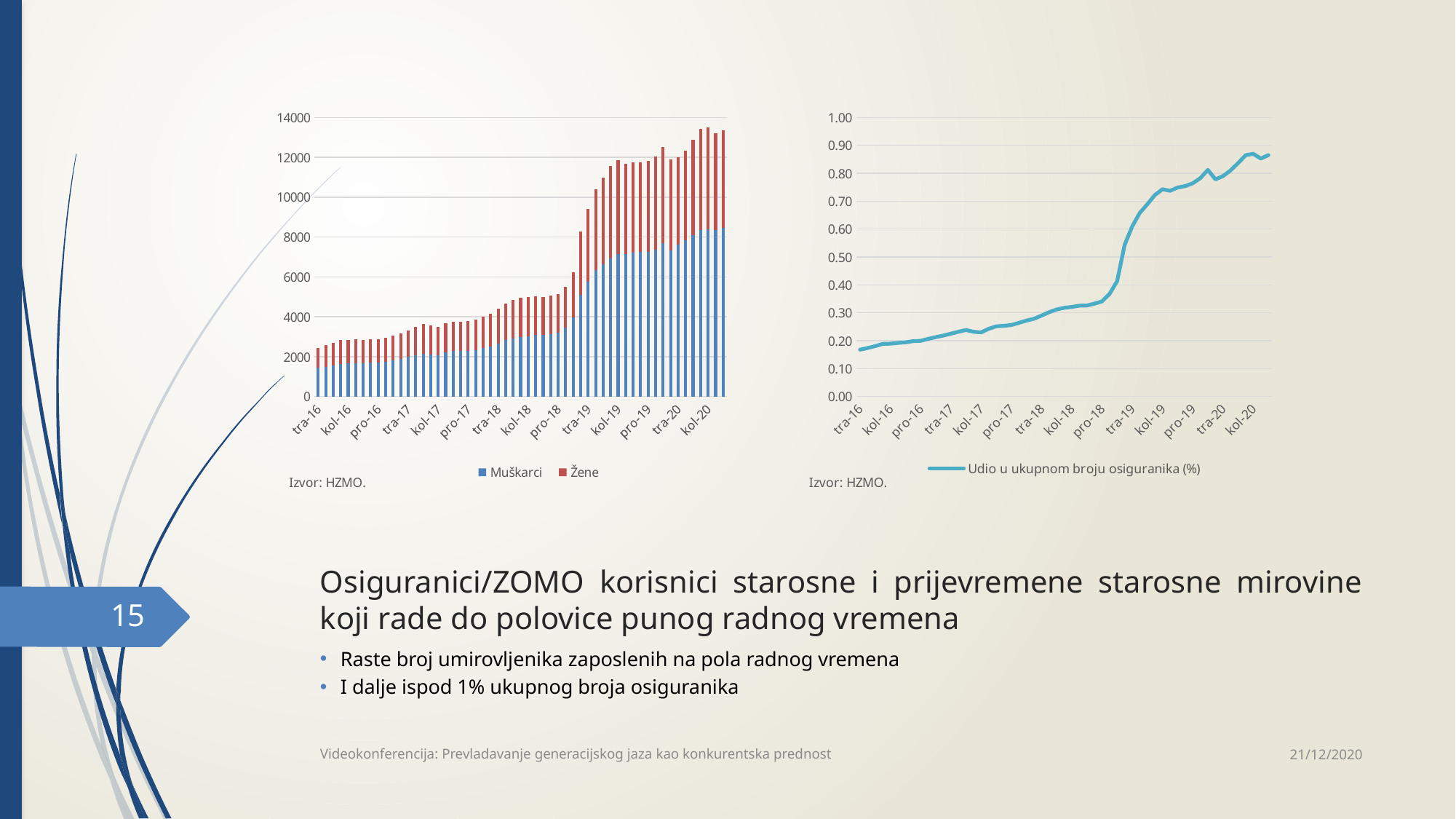
In the right chart, is the value for tra-16 greater or less than 0.20? less In the left chart, do the total bar heights generally rise or fall from tra-16 to kol-20? rise In the right chart, do the values generally rise or fall from tra-16 to kol-20? rise In the right chart, is the value for kol-20 greater or less than 0.80? greater In the left chart, at kol-20, which series is larger, Muškarci or Žene? Muškarci What kind of chart is the chart on the left of the slide? bar chart In the right chart, which labelled period has the lowest value? tra-16 In the left chart, is the Muškarci value for kol-20 greater or less than 8000? greater What is the name of the series plotted in the right chart? Udio u ukupnom broju osiguranika (%) What kind of chart is the chart on the right of the slide? line chart What are the two series named in the legend of the left chart? Muškarci and Žene How many series does the legend of the left chart list? 2